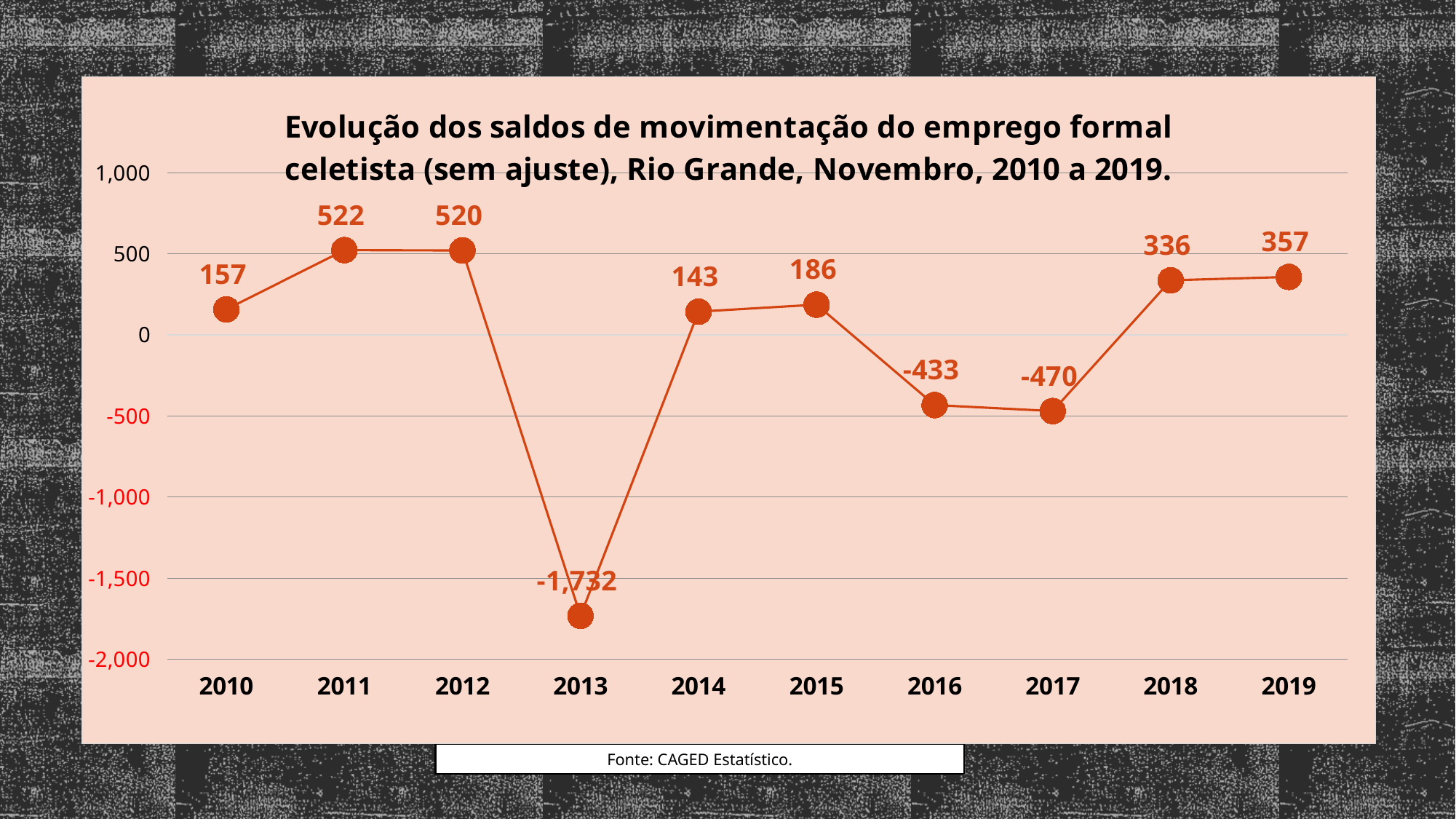
What is the difference between the values for 2015 and 2014? 43 What is the value for 2010? 157 Which year has the lowest value? 2013 What is the value for 2018? 336 Is the value for 2013 greater or less than -1,500? less What is the difference between the values for 2019 and 2018? 21 What is the value for 2013? -1,732 Which is larger, the value for 2016 or the value for 2017? 2016 Which year has the highest value? 2011 How many years are plotted on the chart? 10 What kind of chart is shown on the slide? line chart Do the values rise or fall from 2017 to 2018? rise